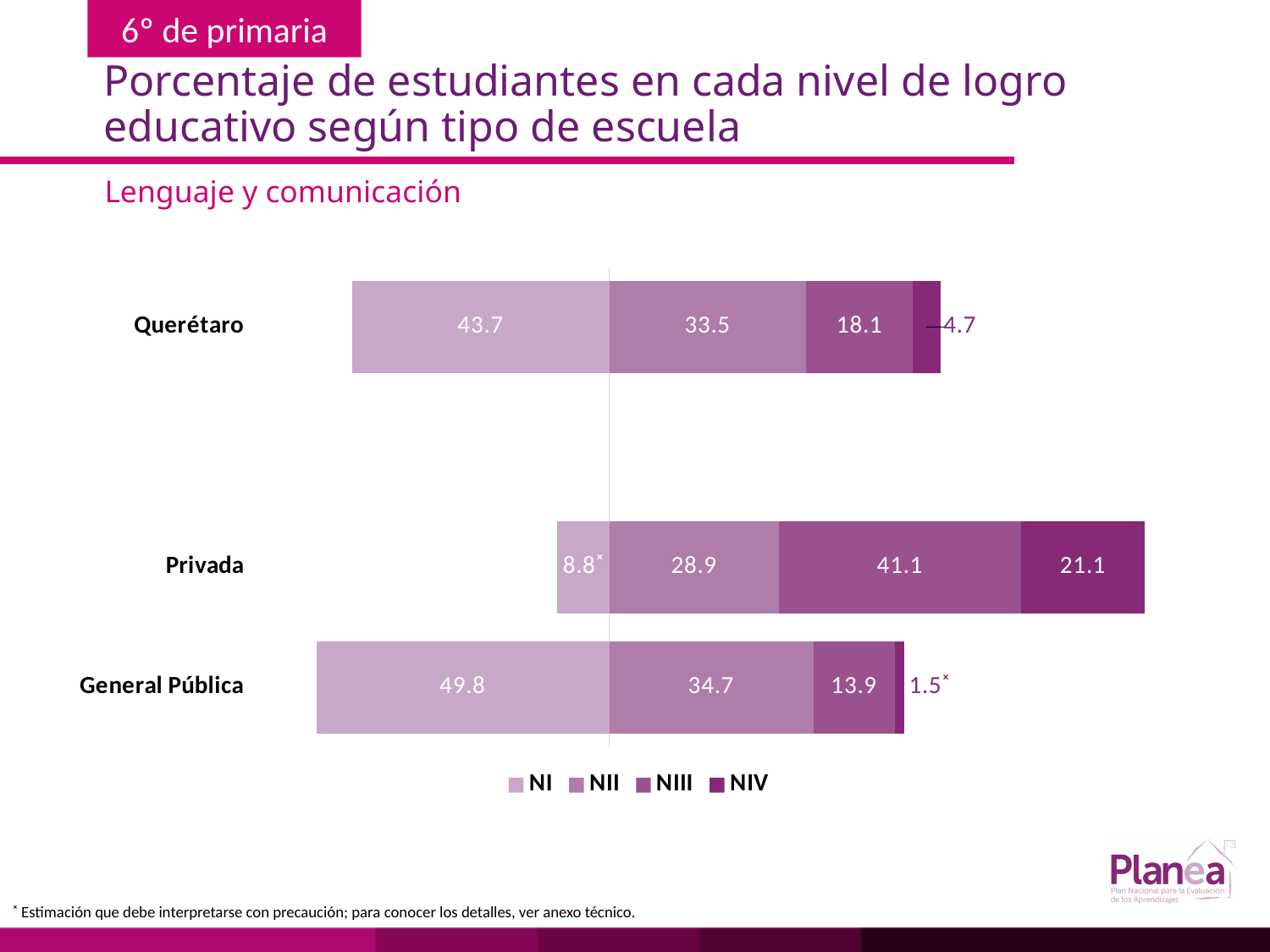
What is the NIII value for General Pública? 13.9 How many series does the legend list? 4 How many school types (categories) are shown in the chart? 3 Which school type has the lowest NIV value? General Pública What is the NIV value for Privada schools? 21.1 What is the difference between the NIII values for Privada and General Pública? 27.2 Which is larger, the NII value for Querétaro or the NII value for Privada? Querétaro What percentage of Querétaro students are at level NI? 43.7 What is the NI value for Privada schools? 8.8 What kind of chart is shown on the slide? Stacked bar chart What is the total of the stacked bar for Querétaro? 100.0 Which school type has the highest NI value? General Pública